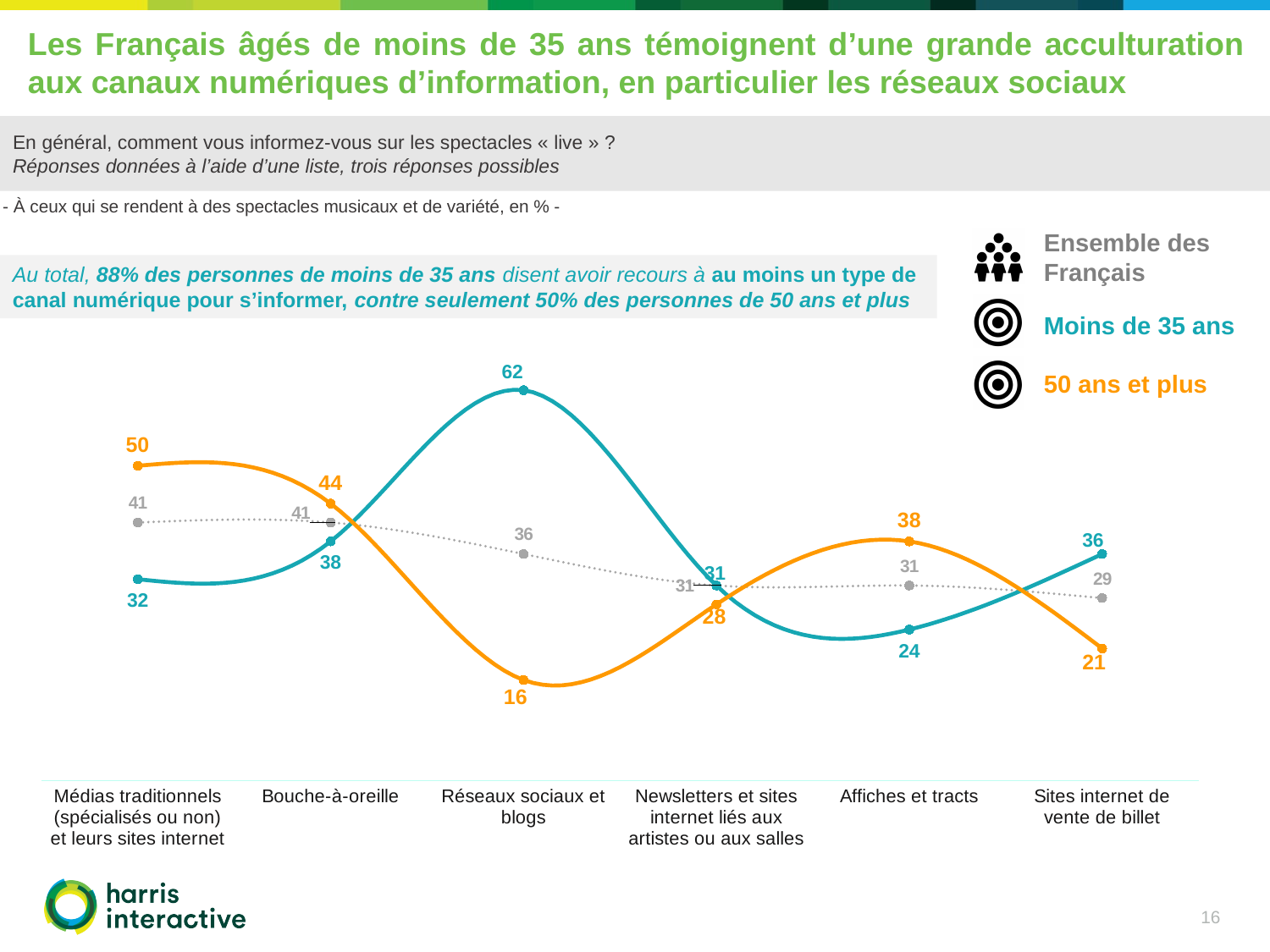
What is the value for 'Moins de 35 ans' for 'Réseaux sociaux et blogs'? 62 What is the value for '50 ans et plus' for 'Affiches et tracts'? 38 How many series does the legend list? 3 What kind of chart is shown on the slide? Line chart What is the difference between the 'Moins de 35 ans' and '50 ans et plus' values for 'Réseaux sociaux et blogs'? 46 Which colour is used for the '50 ans et plus' series? Orange For which category is the 'Moins de 35 ans' value highest? Réseaux sociaux et blogs For which category is the '50 ans et plus' value lowest? Réseaux sociaux et blogs What is the value for 'Ensemble des Français' for 'Sites internet de vente de billet'? 29 What is the value for '50 ans et plus' for 'Médias traditionnels (spécialisés ou non) et leurs sites internet'? 50 Which is larger for 'Sites internet de vente de billet': the 'Moins de 35 ans' value or the '50 ans et plus' value? Moins de 35 ans How many categories are shown on the x axis of the chart? 6